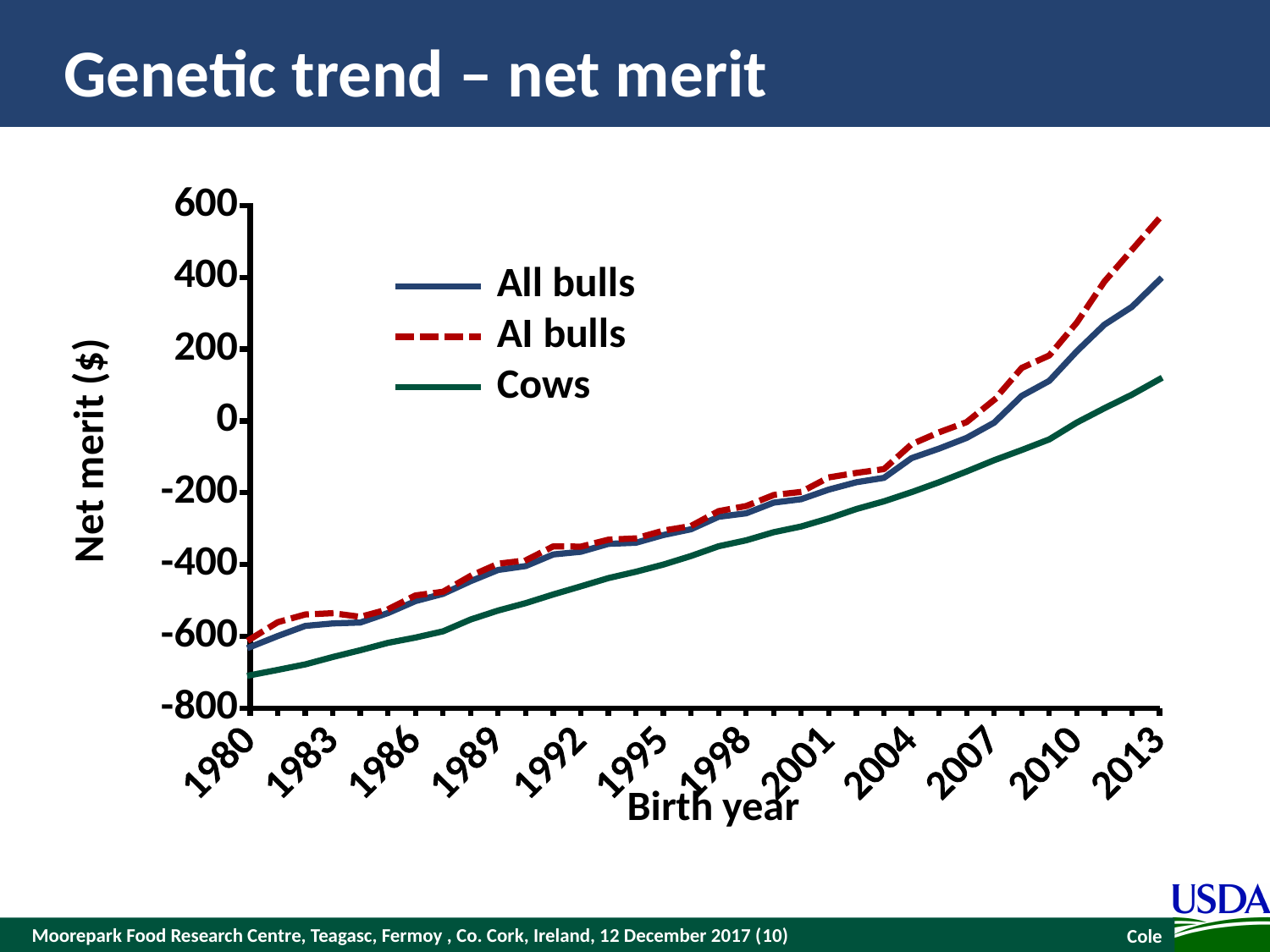
How many series does the legend list? 3 Is the value for Cows in 1980 greater or less than -600? less In 2013, which series has the higher net merit, AI bulls or Cows? AI bulls Is the value for Cows in 2013 greater or less than 0? greater What kind of chart is shown on the slide? line chart What is the title of the x axis? Birth year Do the net merit values for All bulls rise or fall from 1980 to 2013? rise Which series has the highest net merit in 2013? AI bulls Is the value for AI bulls in 1980 greater or less than -400? less Which series has the lowest net merit in 2013? Cows